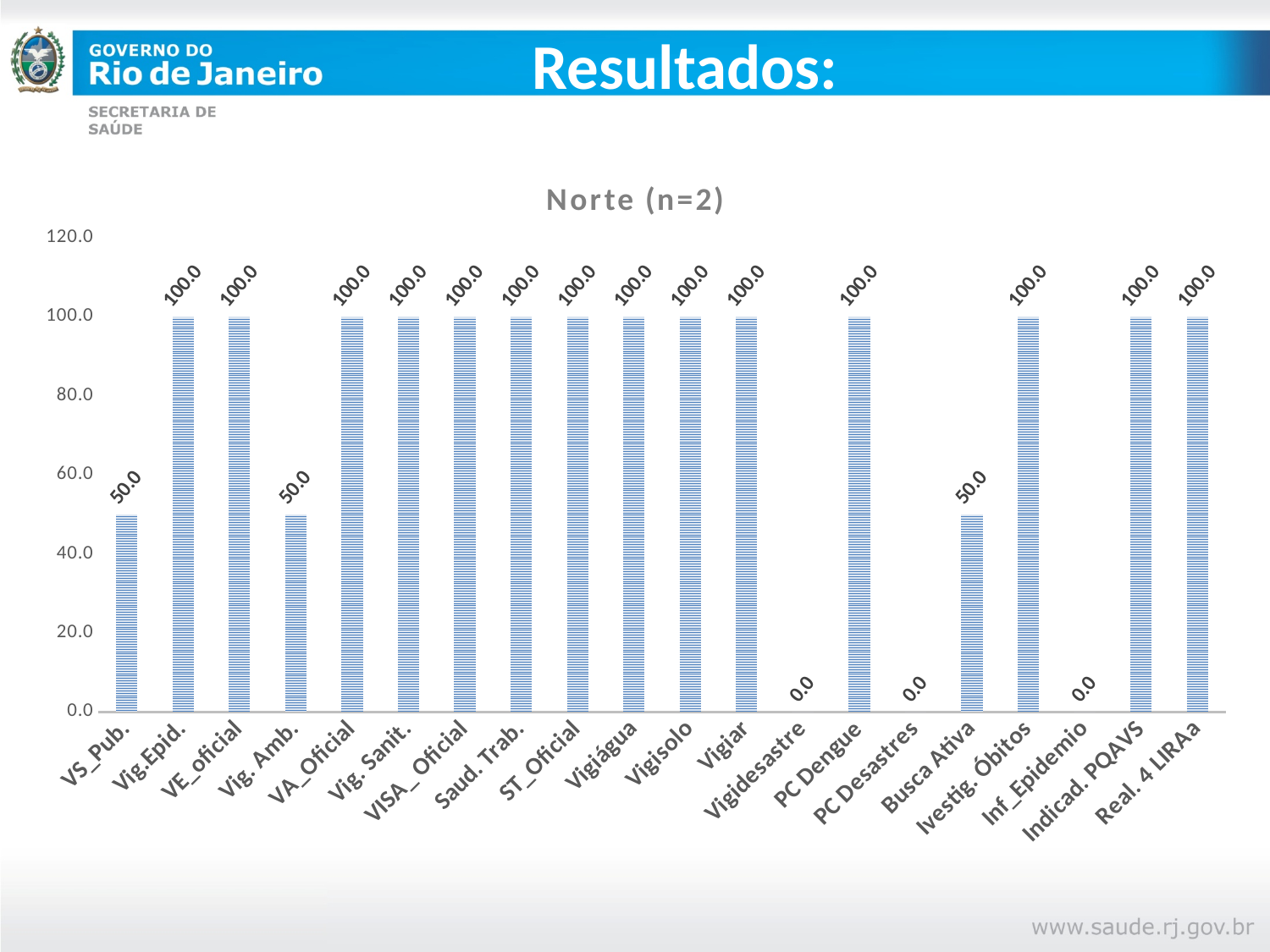
What is the value for Inf_Epidemio? 0.0 Which is larger, the value for Vigiar or the value for Vigidesastre? Vigiar What is the title of the chart? Norte (n=2) What is the value for VS_Pub.? 50.0 What is the value for Vig. Amb.? 50.0 How many categories are shown on the x axis? 20 Which is larger, the value for Busca Ativa or the value for Ivestig. Óbitos? Ivestig. Óbitos What is the difference between the values for Vig.Epid. and VS_Pub.? 50.0 What is the value for Busca Ativa? 50.0 How many categories have a value of 0.0? 3 What is the value for PC Dengue? 100.0 What kind of chart is shown? Bar chart